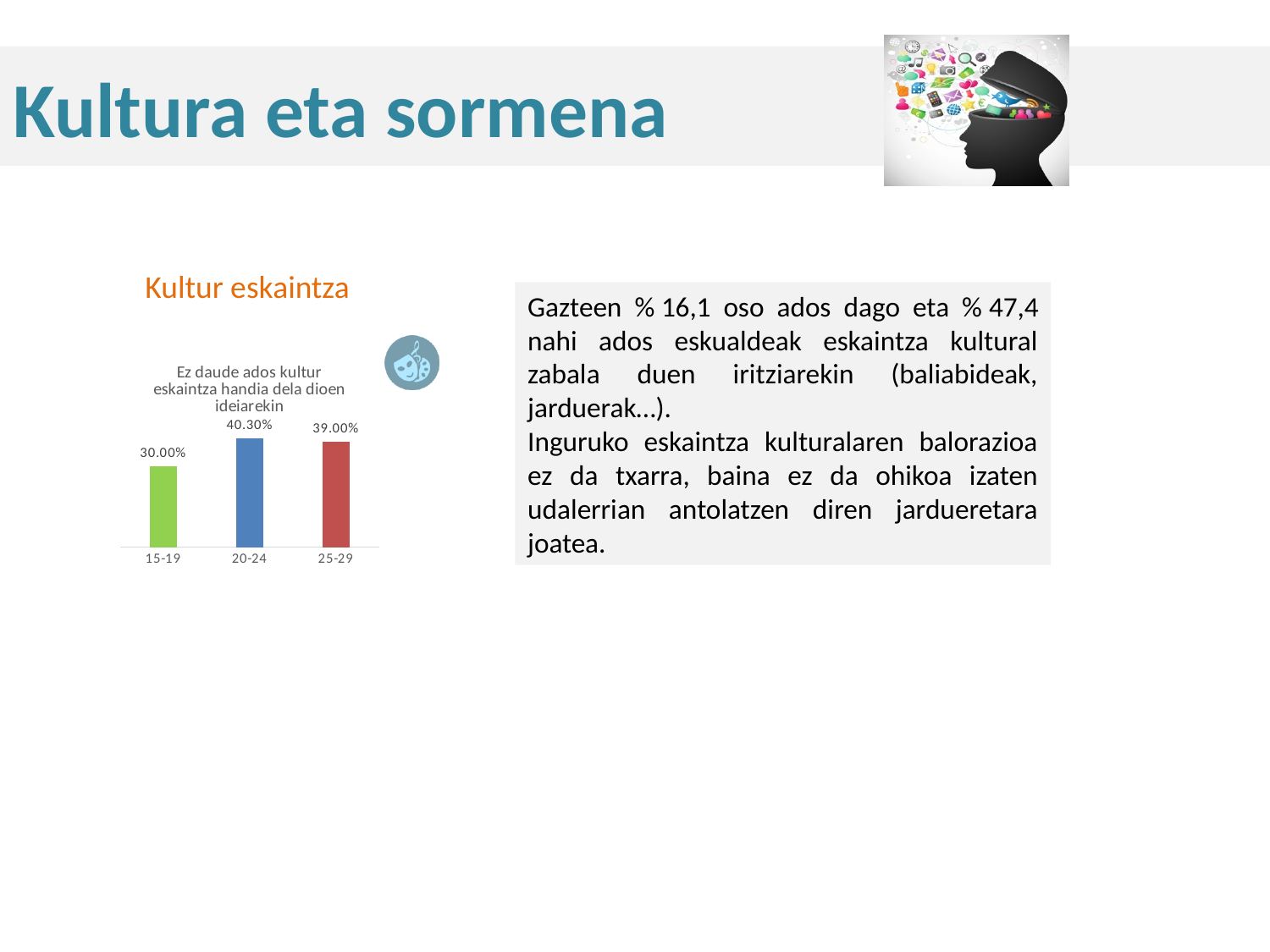
How many age groups are shown in the chart? 3 Which age group has the highest value? 20-24 What is the difference between the values for 20-24 and 15-19? 10.30% Which age group has the lowest value? 15-19 What is the difference between the values for 20-24 and 25-29? 1.30% What is the value for the 15-19 age group? 30.00% What is the value for the 20-24 age group? 40.30% Which has a larger value, 15-19 or 25-29? 25-29 What kind of chart is shown on the slide? Bar chart What is the value for the 25-29 age group? 39.00% What is the title of the chart? Ez daude ados kultur eskaintza handia dela dioen ideiarekin What colour is the bar for the 20-24 age group? Blue